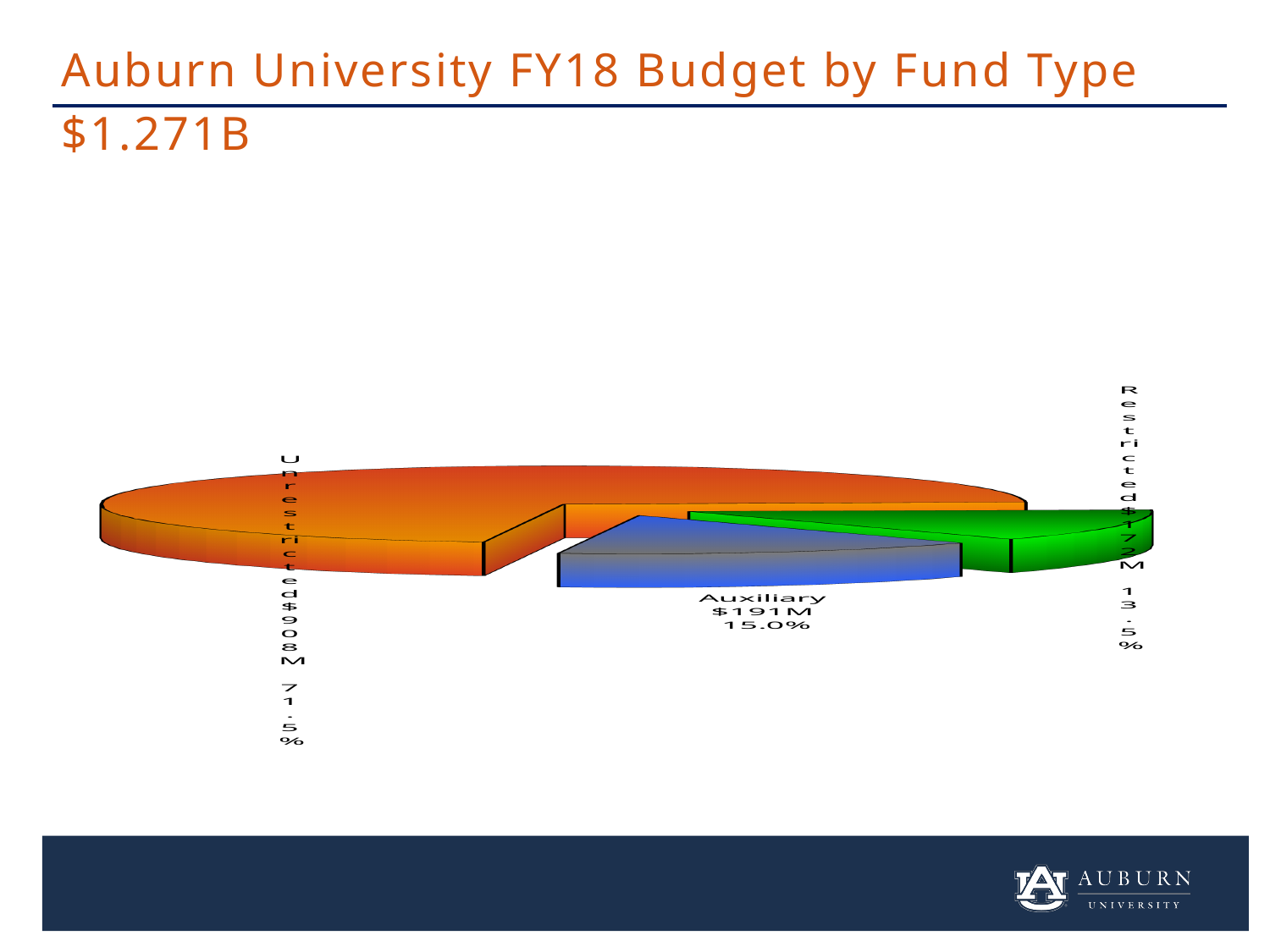
What is the dollar value of the Auxiliary slice? $191M What is the difference in dollars between the Auxiliary and Restricted slices? $19M How many slices does the pie chart have? 3 What is the dollar value of the Unrestricted slice? $908M Which fund type has the largest slice? Unrestricted What share of the pie is Restricted? 13.5% Which fund type has the smallest slice? Restricted What share of the pie is Unrestricted? 71.5% What percentage of the budget is Auxiliary? 15.0% What kind of chart is shown on the slide? pie chart What is the dollar value of the Restricted slice? $172M What total budget amount is stated in the chart title? $1.271B